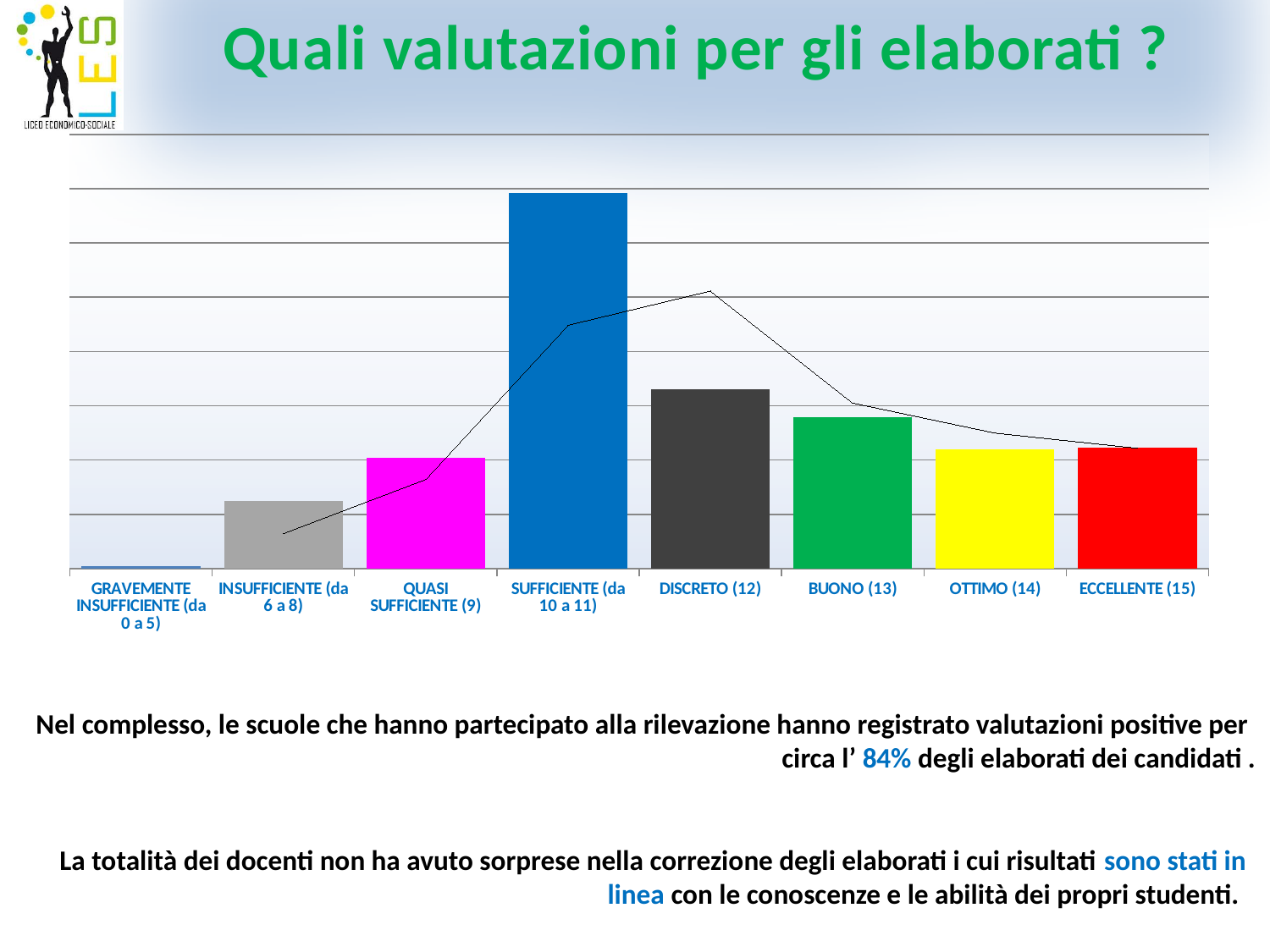
What is the title of the slide containing the chart? Quali valutazioni per gli elaborati ? Which category has the highest bar in the chart? SUFFICIENTE (da 10 a 11) Which bar is taller, INSUFFICIENTE (da 6 a 8) or QUASI SUFFICIENTE (9)? QUASI SUFFICIENTE (9) Which bar is taller, DISCRETO (12) or BUONO (13)? DISCRETO (12) Which bar is taller, SUFFICIENTE (da 10 a 11) or DISCRETO (12)? SUFFICIENTE (da 10 a 11) What colour is the bar for SUFFICIENTE (da 10 a 11)? blue How many categories are shown on the x axis of the chart? 8 Do the bar values rise or fall from GRAVEMENTE INSUFFICIENTE (da 0 a 5) to SUFFICIENTE (da 10 a 11)? rise What kind of chart is shown on the slide? bar chart Which category has the lowest bar in the chart? GRAVEMENTE INSUFFICIENTE (da 0 a 5)